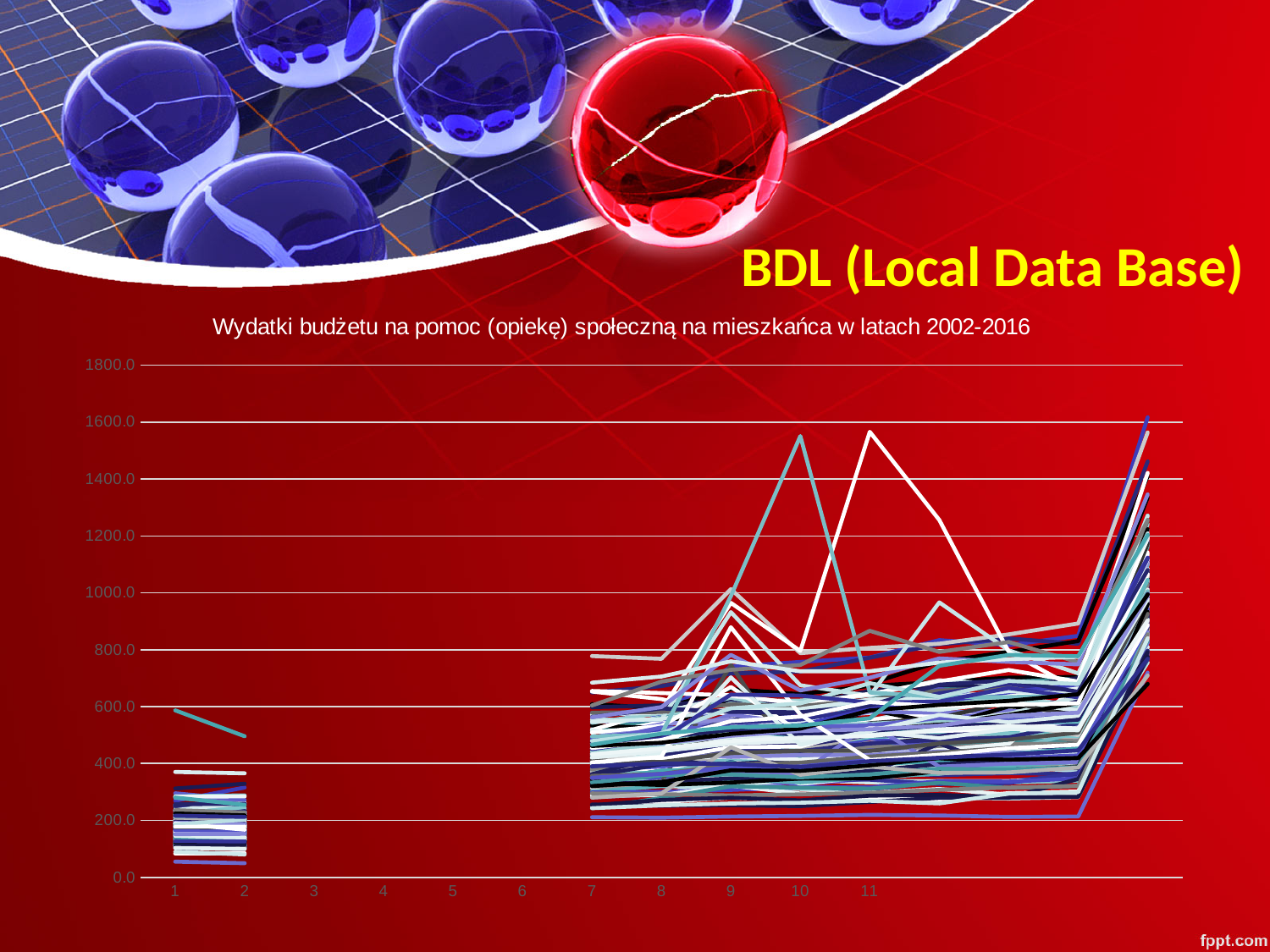
Is the highest value plotted on the chart greater or less than 1400.0? greater What is the title of the chart? Wydatki budżetu na pomoc (opiekę) społeczną na mieszkańca w latach 2002-2016 What kind of chart is shown on the slide? line chart What is the highest value labelled on the vertical axis of the chart? 1800.0 Is the lowest value plotted on the chart greater or less than 200.0? less How many numbered categories are labelled on the horizontal axis of the chart? 11 Is the highest value plotted at category 10 greater or less than 1400.0? greater